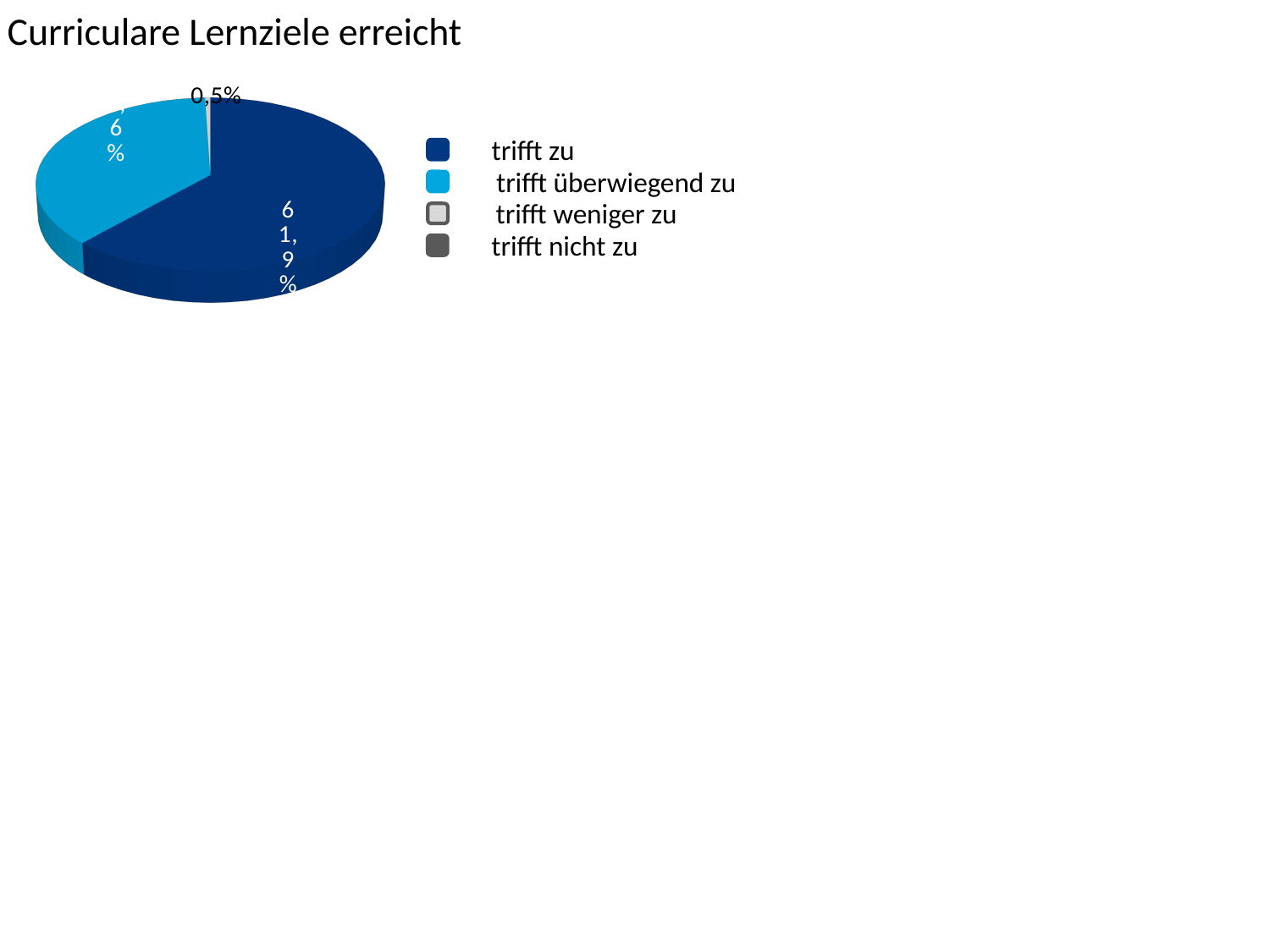
Which category has the largest slice of the pie? trifft zu What colour represents "trifft zu" in the chart? dark blue What is the title of the chart? Curriculare Lernziele erreicht What share of the pie does "trifft zu" take? 61,9% Which slice is larger, "trifft zu" or "trifft überwiegend zu"? trifft zu What percentage is shown for "trifft weniger zu"? 0,5% What percentage is shown for "trifft zu"? 61,9% How many entries does the legend list? 4 Which slice is larger, "trifft überwiegend zu" or "trifft weniger zu"? trifft überwiegend zu What kind of chart is shown on the slide? pie chart